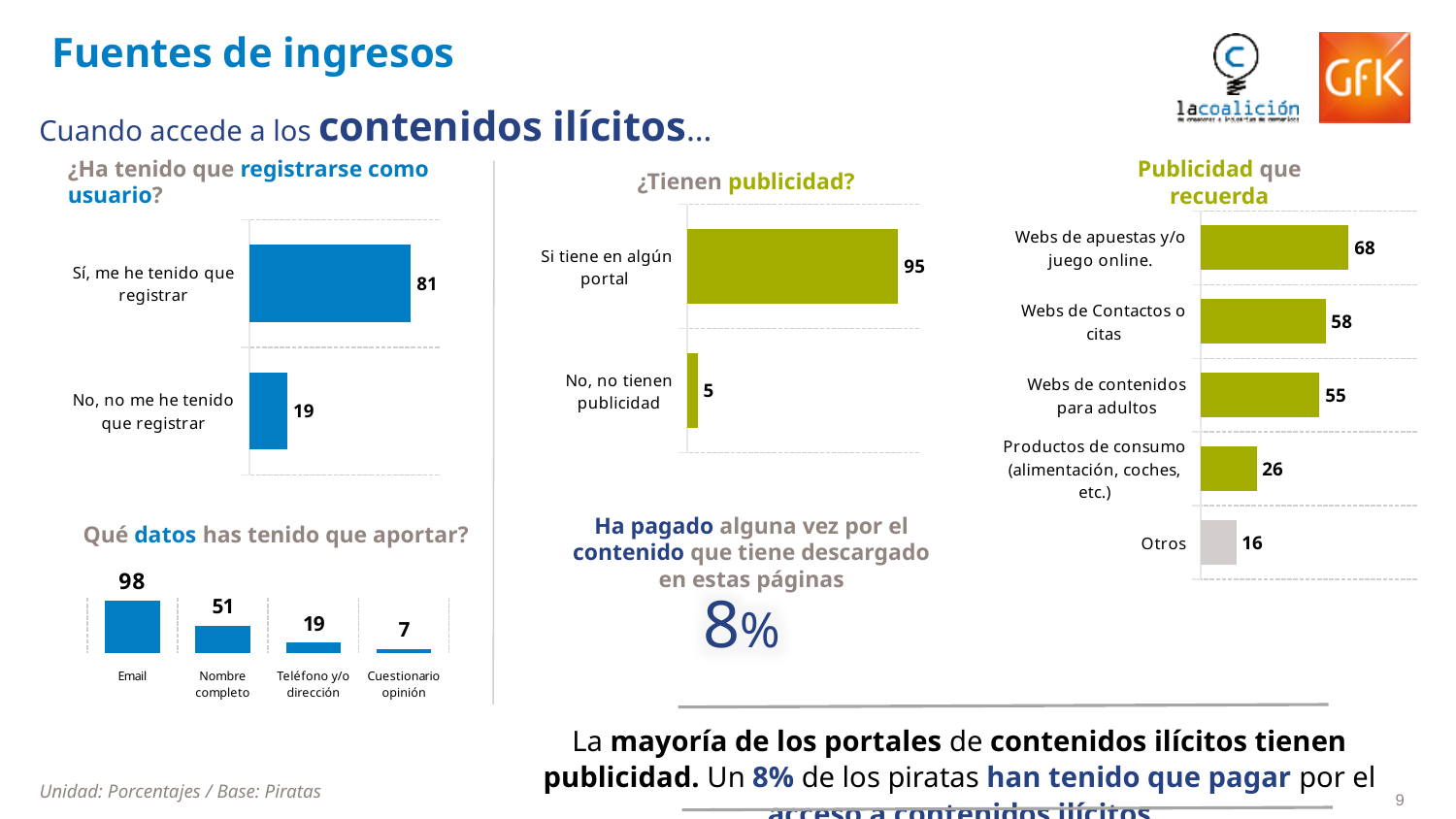
In the chart 'Publicidad que recuerda', what is the value for 'Webs de Contactos o citas'? 58 In the chart 'Qué datos has tenido que aportar?', what is the value for 'Nombre completo'? 51 In the chart 'Qué datos has tenido que aportar?', how many categories are shown? 4 In the chart 'Qué datos has tenido que aportar?', do the values rise or fall from left to right? fall In the chart 'Publicidad que recuerda', how many categories are shown? 5 In the chart 'Publicidad que recuerda', which category has the lowest value? Otros In the chart '¿Tienen publicidad?', what kind of chart is used? bar chart In the chart '¿Ha tenido que registrarse como usuario?', what is the value for 'Sí, me he tenido que registrar'? 81 In the chart '¿Ha tenido que registrarse como usuario?', what is the difference between 'Sí, me he tenido que registrar' and 'No, no me he tenido que registrar'? 62 In the chart 'Qué datos has tenido que aportar?', which category has the highest value? Email In the chart 'Publicidad que recuerda', which is larger: 'Webs de contenidos para adultos' or 'Productos de consumo (alimentación, coches, etc.)'? Webs de contenidos para adultos In the chart '¿Tienen publicidad?', what is the value for 'No, no tienen publicidad'? 5